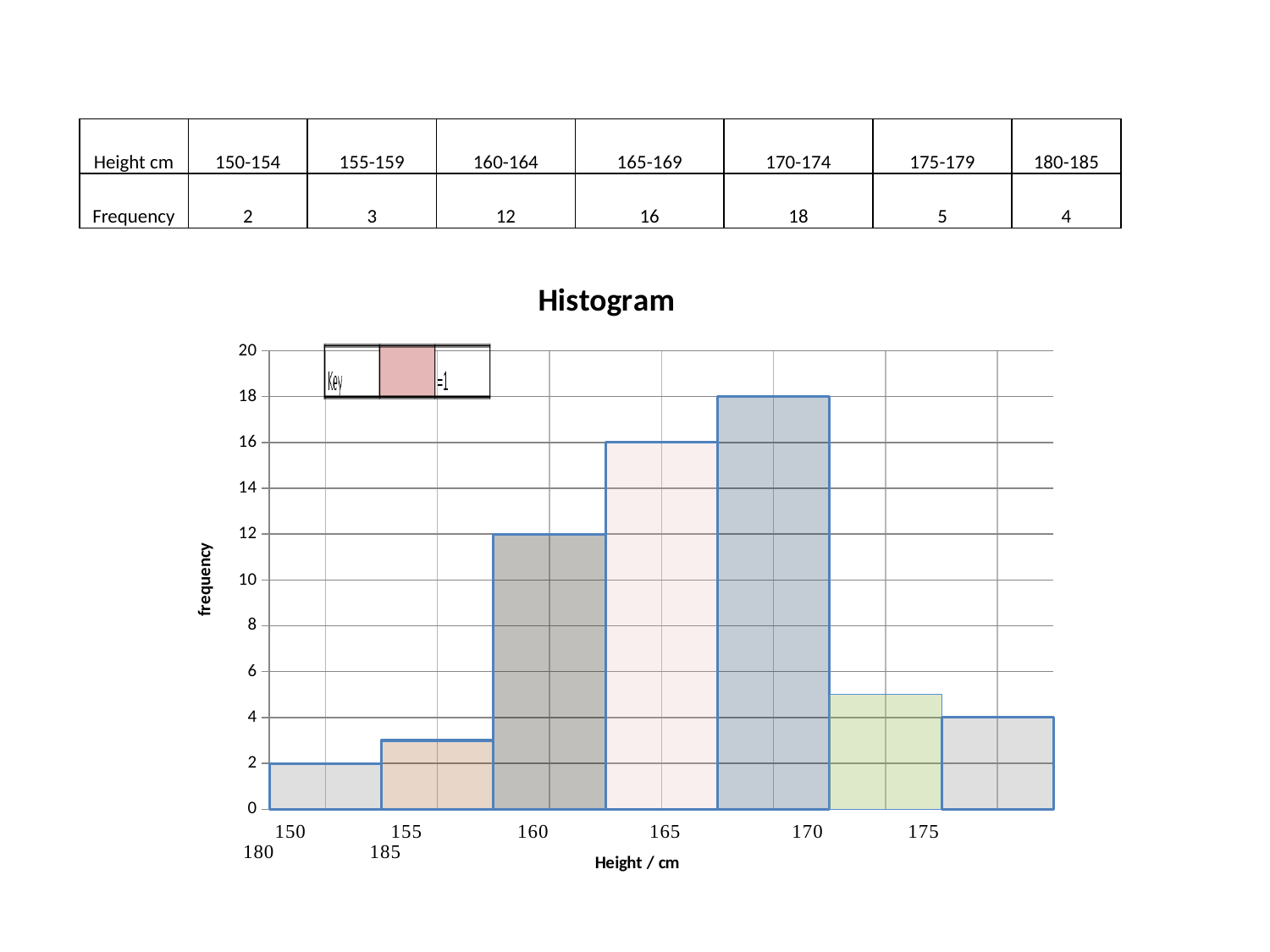
Is the frequency for the 165-169 class greater or less than 10? greater What is the frequency for the 160-164 height class? 12 How many height classes are shown in the histogram? 7 What is the label on the vertical axis of the chart? frequency What is the difference in frequency between the 160-164 class and the 155-159 class? 9 What is the frequency for the 150-154 height class? 2 Which height class has the lowest frequency? 150-154 Which has the larger frequency, the 175-179 class or the 180-185 class? 175-179 What kind of chart is shown on the slide? Histogram (bar chart) What is the frequency for the 170-174 height class? 18 What is the difference in frequency between the 170-174 class and the 165-169 class? 2 Which height class has the highest frequency? 170-174